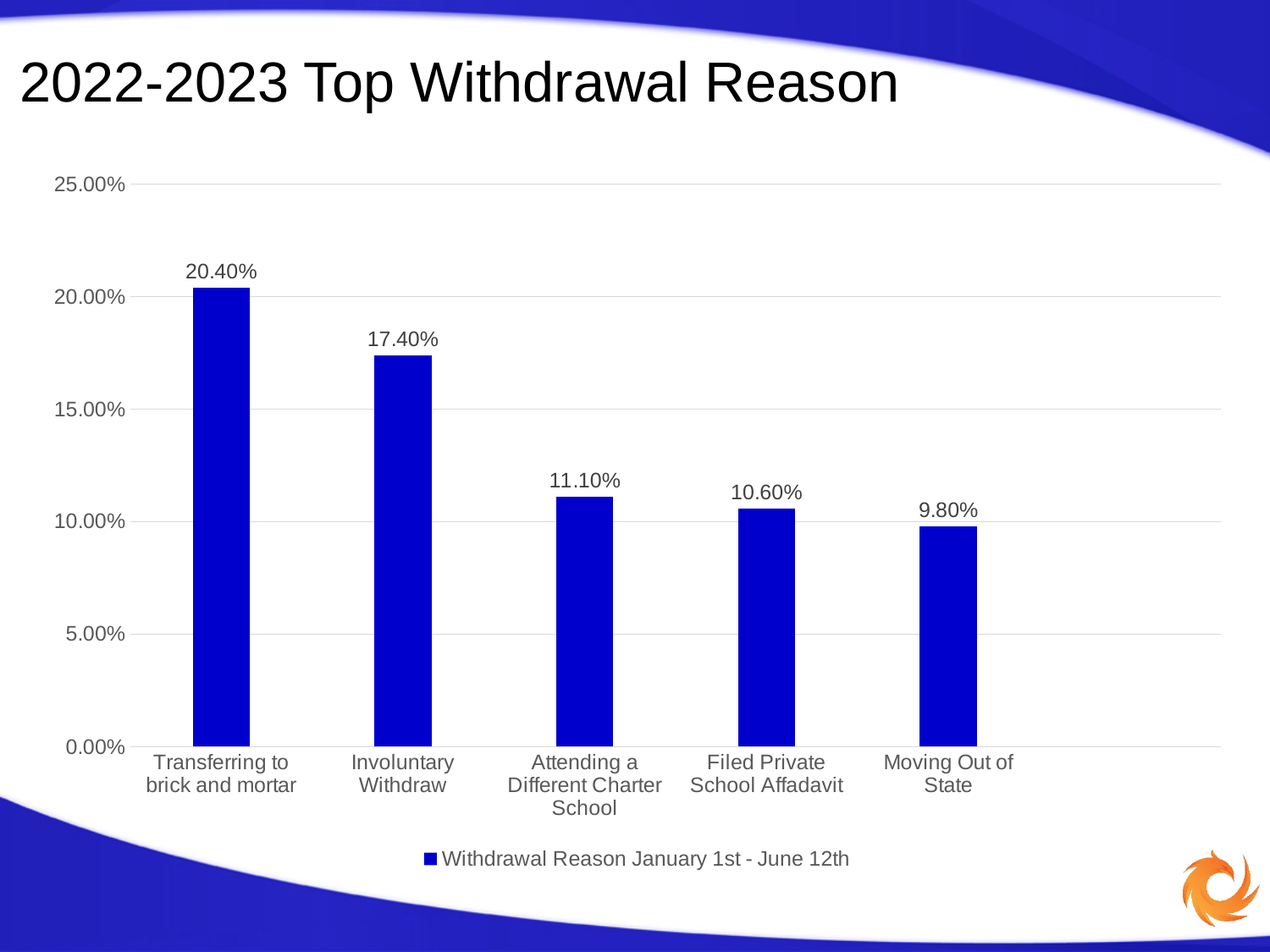
What is the value for Attending a Different Charter School? 11.10% What is the value for Involuntary Withdraw? 17.40% Which withdrawal reason has the highest value? Transferring to brick and mortar What is the value for Moving Out of State? 9.80% What kind of chart is shown on the slide? Bar chart Which is larger, the value for Attending a Different Charter School or the value for Filed Private School Affadavit? Attending a Different Charter School What is the value for Filed Private School Affadavit? 10.60% What is the value for Transferring to brick and mortar? 20.40% Which withdrawal reason has the lowest value? Moving Out of State How many withdrawal reasons are shown on the chart? 5 What is the legend entry shown below the chart? Withdrawal Reason January 1st - June 12th What is the difference between the values for Transferring to brick and mortar and Involuntary Withdraw? 3.00%